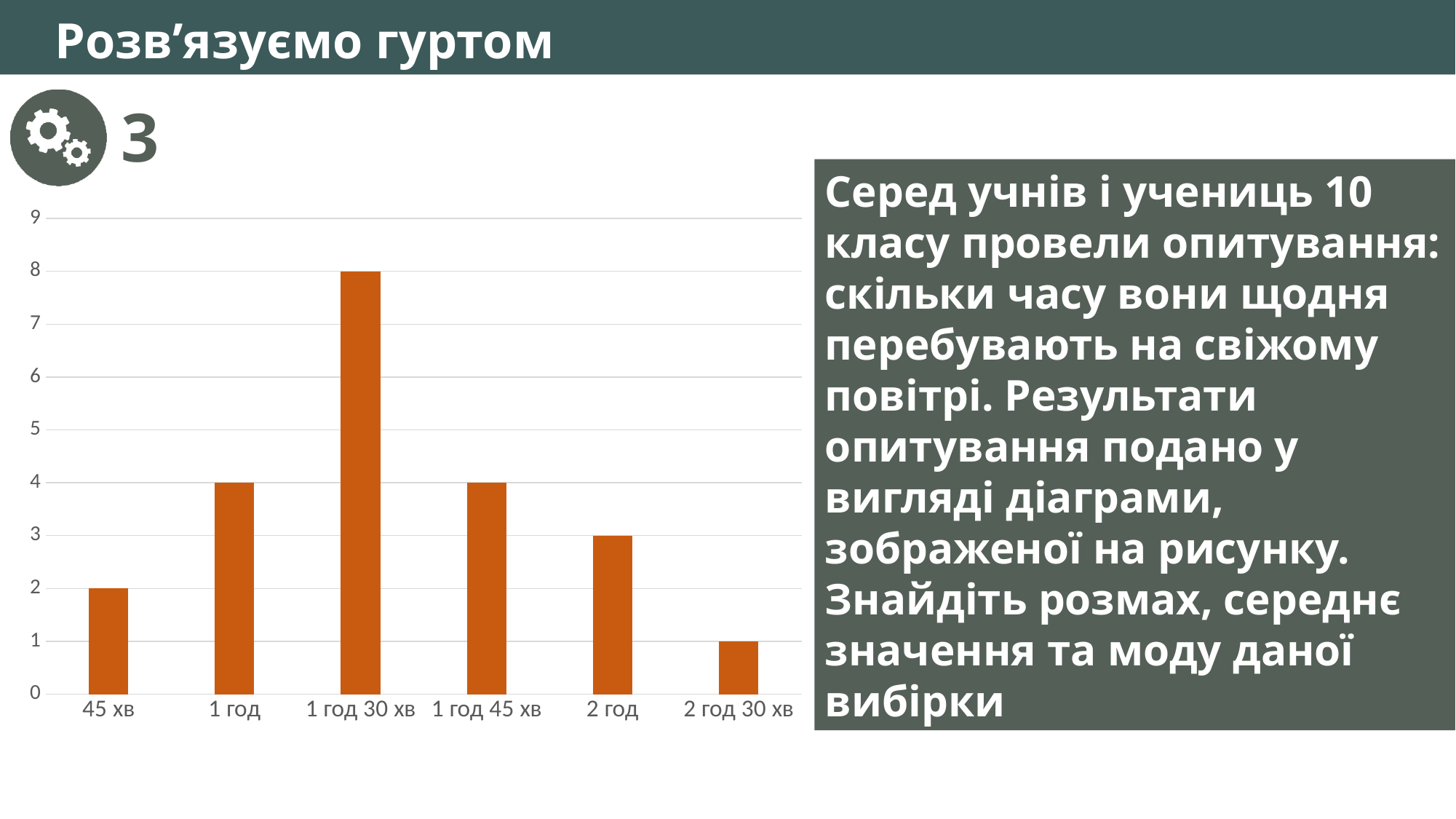
What kind of chart is shown on the slide? bar chart What is the value of the bar for 2 год? 3 Which is larger, the value for 1 год or the value for 2 год? 1 год What is the difference between the values for 1 год 30 хв and 2 год 30 хв? 7 Which category has the highest bar in the chart? 1 год 30 хв How many categories are shown on the x axis of the chart? 6 What is the value of the bar for 1 год 45 хв? 4 What is the value of the bar for 1 год 30 хв? 8 Is the value for 1 год 30 хв greater or less than 5? greater What is the value of the bar for 45 хв? 2 Which category has the lowest bar in the chart? 2 год 30 хв What is the highest tick value shown on the vertical axis of the chart? 9